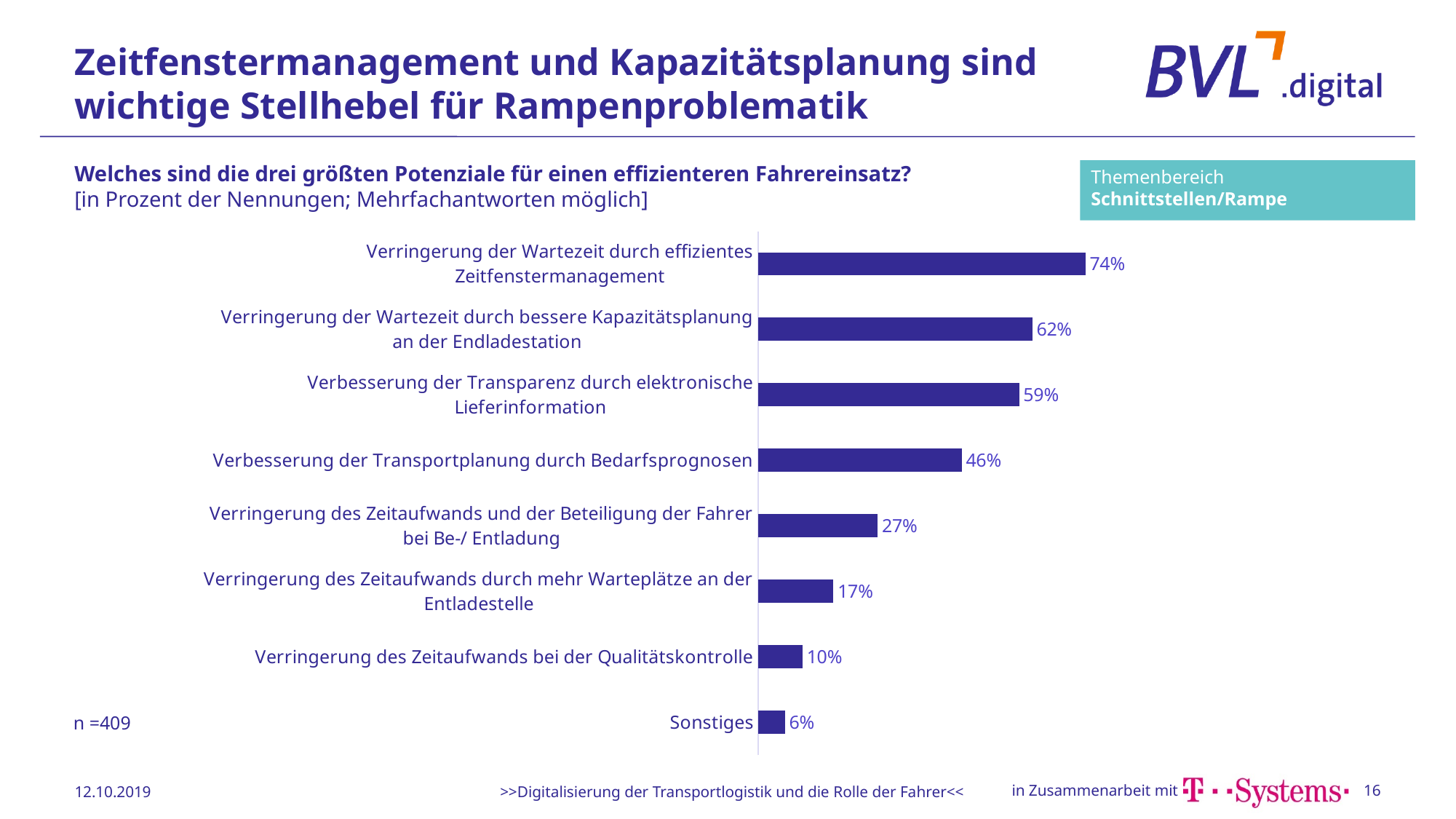
What value is shown for "Verbesserung der Transportplanung durch Bedarfsprognosen"? 46% Which category has the lowest value? Sonstiges What is the difference between the highest and lowest values in the chart? 68% What value is shown for "Verringerung des Zeitaufwands bei der Qualitätskontrolle"? 10% What is the difference between the values for "Verringerung der Wartezeit durch bessere Kapazitätsplanung an der Endladestation" and "Verbesserung der Transparenz durch elektronische Lieferinformation"? 3% What kind of chart is shown on the slide? Bar chart Which is larger: the value for "Verringerung des Zeitaufwands und der Beteiligung der Fahrer bei Be-/ Entladung" or for "Verringerung des Zeitaufwands durch mehr Warteplätze an der Entladestelle"? Verringerung des Zeitaufwands und der Beteiligung der Fahrer bei Be-/ Entladung What percentage is shown for "Verringerung der Wartezeit durch effizientes Zeitfenstermanagement"? 74% What is the sample size (n) stated on the slide? 409 Which category has the highest value? Verringerung der Wartezeit durch effizientes Zeitfenstermanagement What percentage is shown for "Sonstiges"? 6% How many categories are shown in the chart? 8